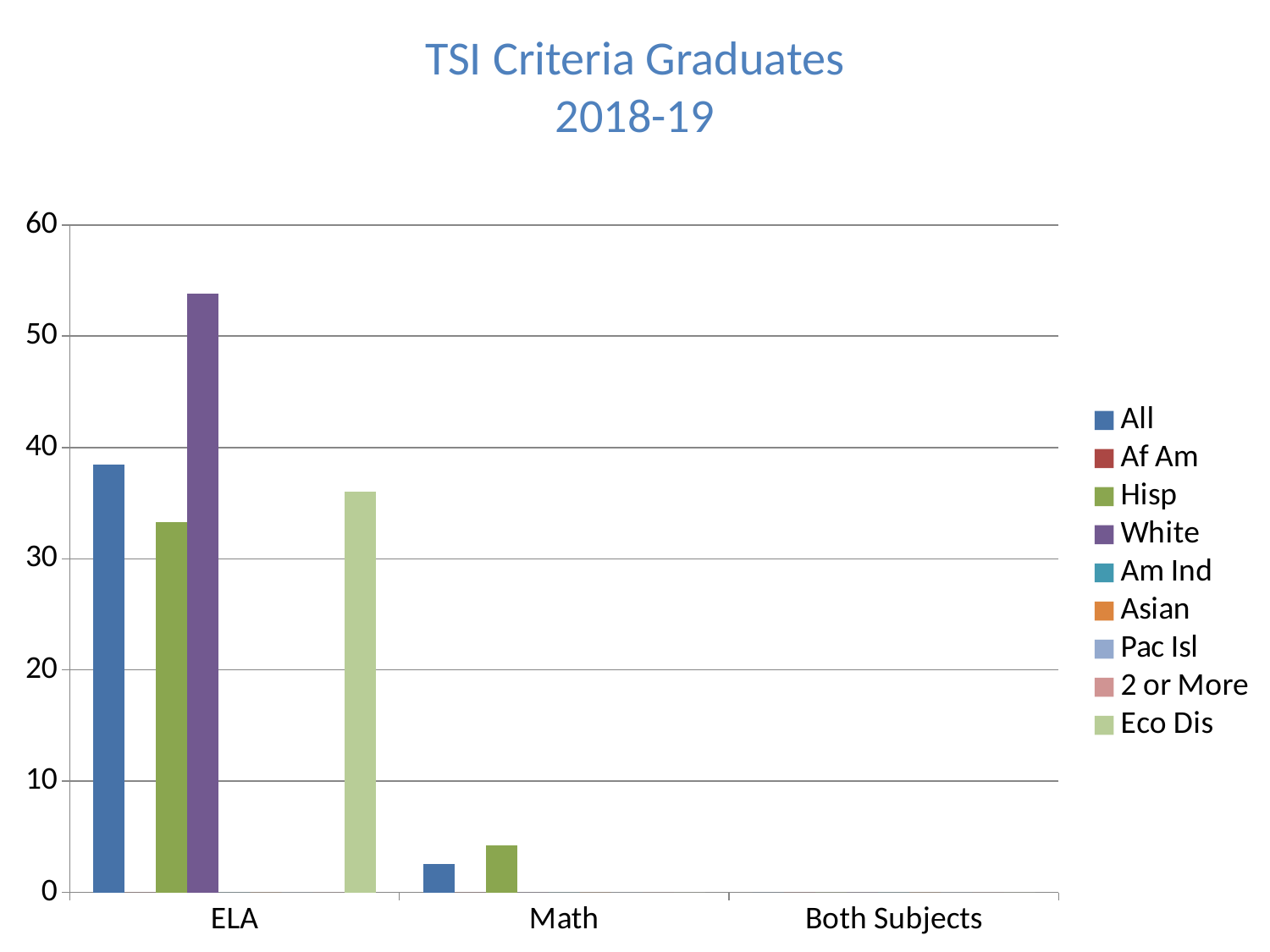
How many categories are shown on the x axis? 3 How many series does the legend list? 9 What kind of chart is shown on the slide? bar chart Which category on the x axis is listed last? Both Subjects Is the value for All in the ELA category greater or less than 40? less Is the value for White in the ELA category greater or less than 50? greater Which series has the highest value in the ELA category? White Which is larger in the Math category, the value for All or the value for Hisp? Hisp Is the value for Hisp in the Math category greater or less than 10? less Does the value for All rise or fall from ELA to Math? fall Which is larger in the ELA category, the value for All or the value for Hisp? All What is the title of the chart? TSI Criteria Graduates 2018-19